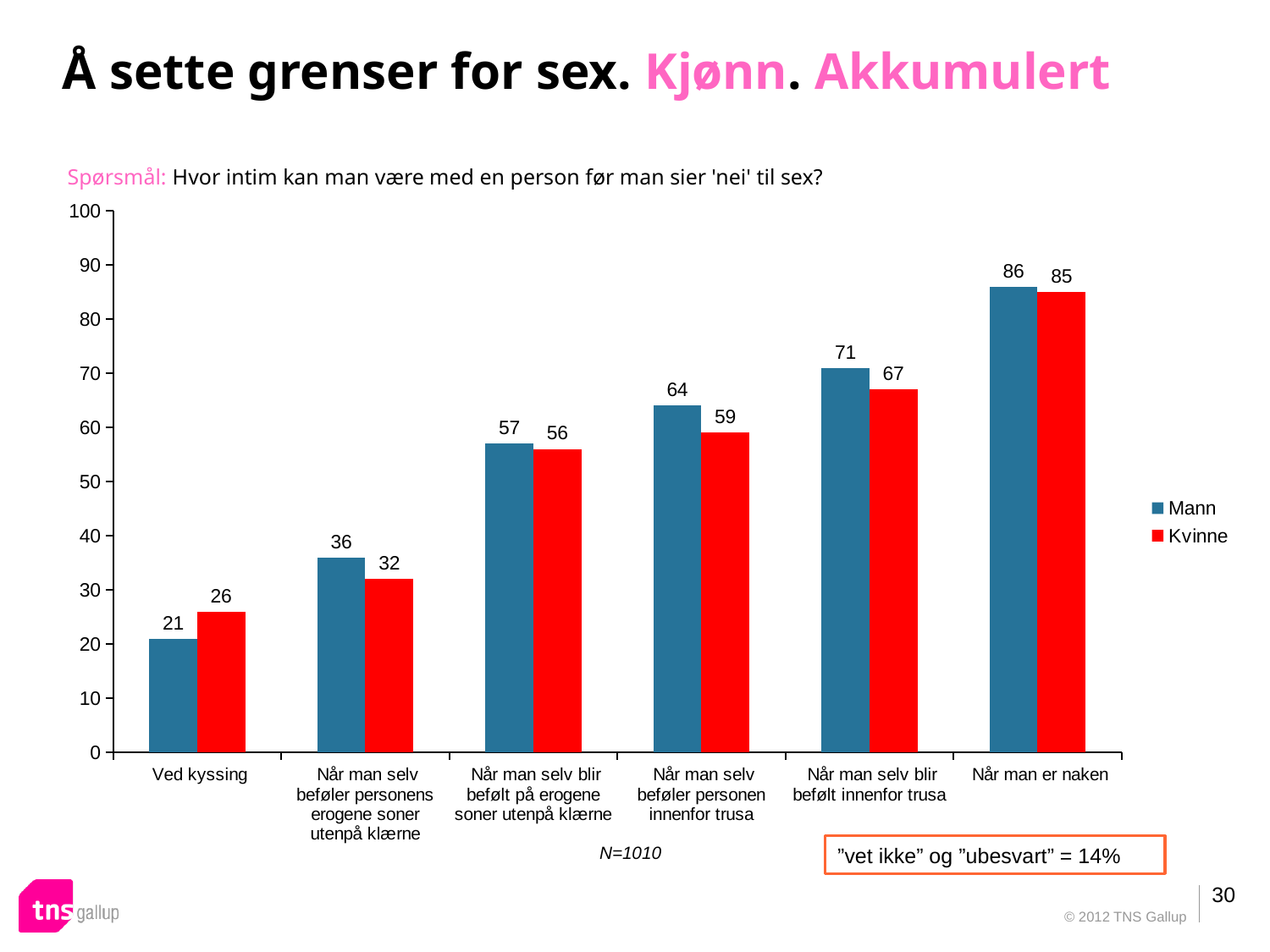
Which is larger at 'Ved kyssing', Mann or Kvinne? Kvinne What is the value for Kvinne at 'Når man selv blir befølt innenfor trusa'? 67 Which category has the lowest value for Kvinne? Ved kyssing What kind of chart is shown on the slide? bar chart Which category has the highest value for Mann? Når man er naken How many categories are shown on the x axis? 6 How many series does the legend list? 2 What is the value for Kvinne at 'Når man er naken'? 85 Is the value for Mann at 'Når man selv blir befølt på erogene soner utenpå klærne' greater or less than 50? greater Do the values for Mann rise or fall from left to right along the x axis? rise What is the value for Mann at 'Ved kyssing'? 21 What is the difference between Mann and Kvinne at 'Når man selv beføler personen innenfor trusa'? 5